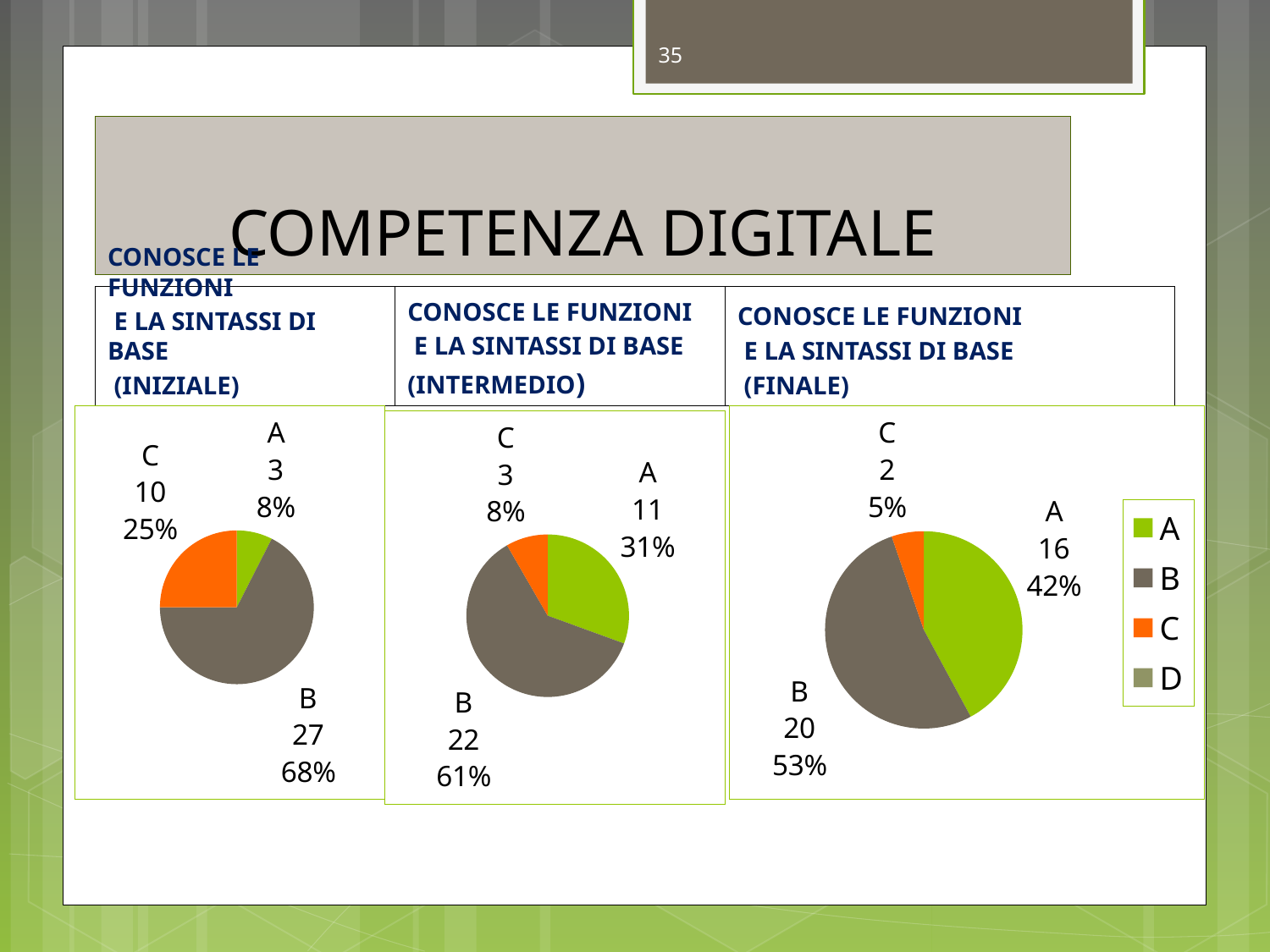
In the FINALE pie chart, what percentage share does category A have? 42% In the INIZIALE pie chart, what is the value for category B? 27 In the INIZIALE pie chart, which category has the smallest slice? A What type of chart is used on this slide? Pie chart In the FINALE pie chart, which category has the largest slice? B In the INTERMEDIO pie chart, what is the value for category A? 11 In the INIZIALE pie chart, what percentage share does category C have? 25% In the INTERMEDIO pie chart, what percentage share does category B have? 61% How many entries does the legend next to the FINALE chart list? 4 In the FINALE pie chart, what is the difference between the values for B and A? 4 In the FINALE pie chart, what is the value for category C? 2 In the INTERMEDIO pie chart, which is larger, the value for A or the value for C? A